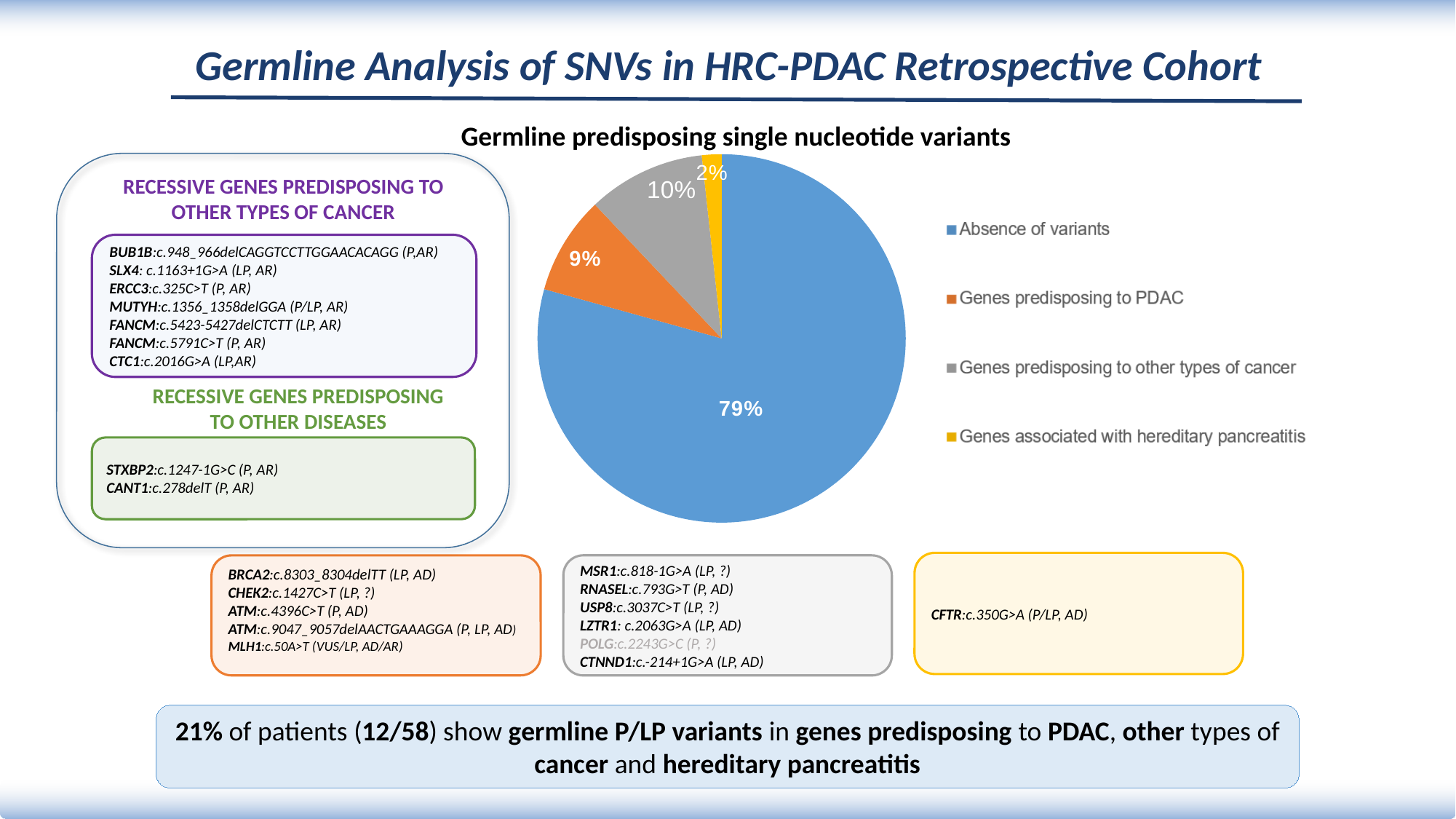
What percentage of the pie is 'Genes associated with hereditary pancreatitis'? 2% What percentage of the pie is 'Genes predisposing to PDAC'? 9% What is the difference in percentage points between 'Absence of variants' and 'Genes predisposing to other types of cancer'? 69 What type of chart is shown on the slide? pie chart Which category has the smallest slice of the pie? Genes associated with hereditary pancreatitis Which category has the largest slice of the pie? Absence of variants Which is larger: the slice for 'Genes predisposing to PDAC' or the slice for 'Genes associated with hereditary pancreatitis'? Genes predisposing to PDAC What is the title of the chart? Germline predisposing single nucleotide variants What percentage of the pie is 'Genes predisposing to other types of cancer'? 10% How many categories does the legend list? 4 What percentage of the pie is 'Absence of variants'? 79% What colour is the slice for 'Genes predisposing to PDAC'? orange